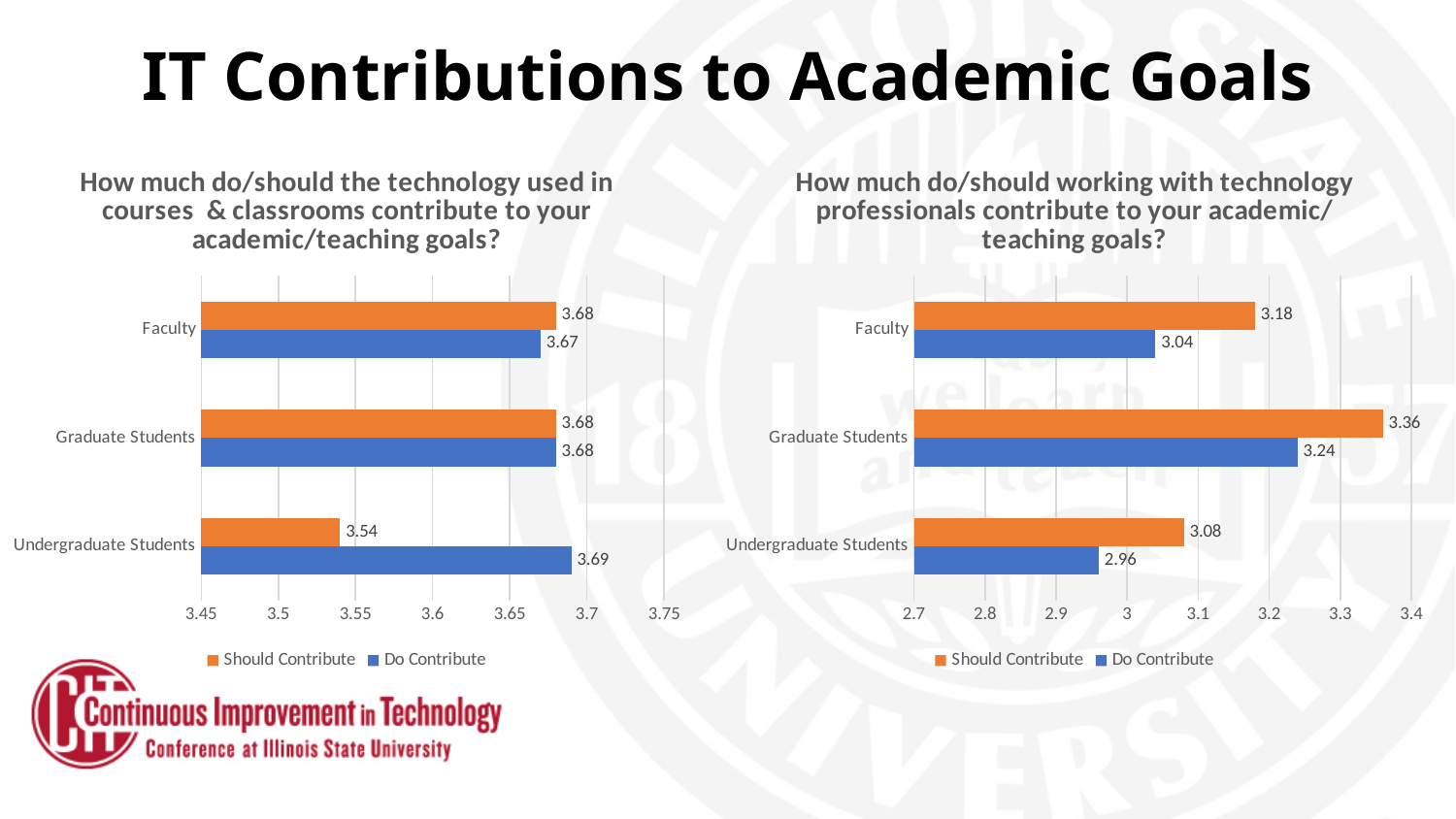
In the right chart (working with technology professionals), what is the difference between the 'Should Contribute' and 'Do Contribute' values for Faculty? 0.14 In the right chart (working with technology professionals), what is the 'Should Contribute' value for Graduate Students? 3.36 In the right chart (working with technology professionals), which group has the lowest 'Do Contribute' value? Undergraduate Students In the left chart (technology used in courses & classrooms), what is the 'Should Contribute' value for Undergraduate Students? 3.54 What kind of chart is the right chart (working with technology professionals)? Bar chart In the left chart (technology used in courses & classrooms), which group has the lowest 'Should Contribute' value? Undergraduate Students In the left chart (technology used in courses & classrooms), what is the difference between the 'Do Contribute' and 'Should Contribute' values for Undergraduate Students? 0.15 In the right chart (working with technology professionals), is the 'Should Contribute' value for Graduate Students larger or smaller than the 'Do Contribute' value for Graduate Students? larger In the right chart (working with technology professionals), what is the 'Do Contribute' value for Undergraduate Students? 2.96 In the right chart (working with technology professionals), which group has the highest 'Should Contribute' value? Graduate Students How many series does the legend of the left chart list? 2 In the left chart (technology used in courses & classrooms), what is the 'Do Contribute' value for Faculty? 3.67